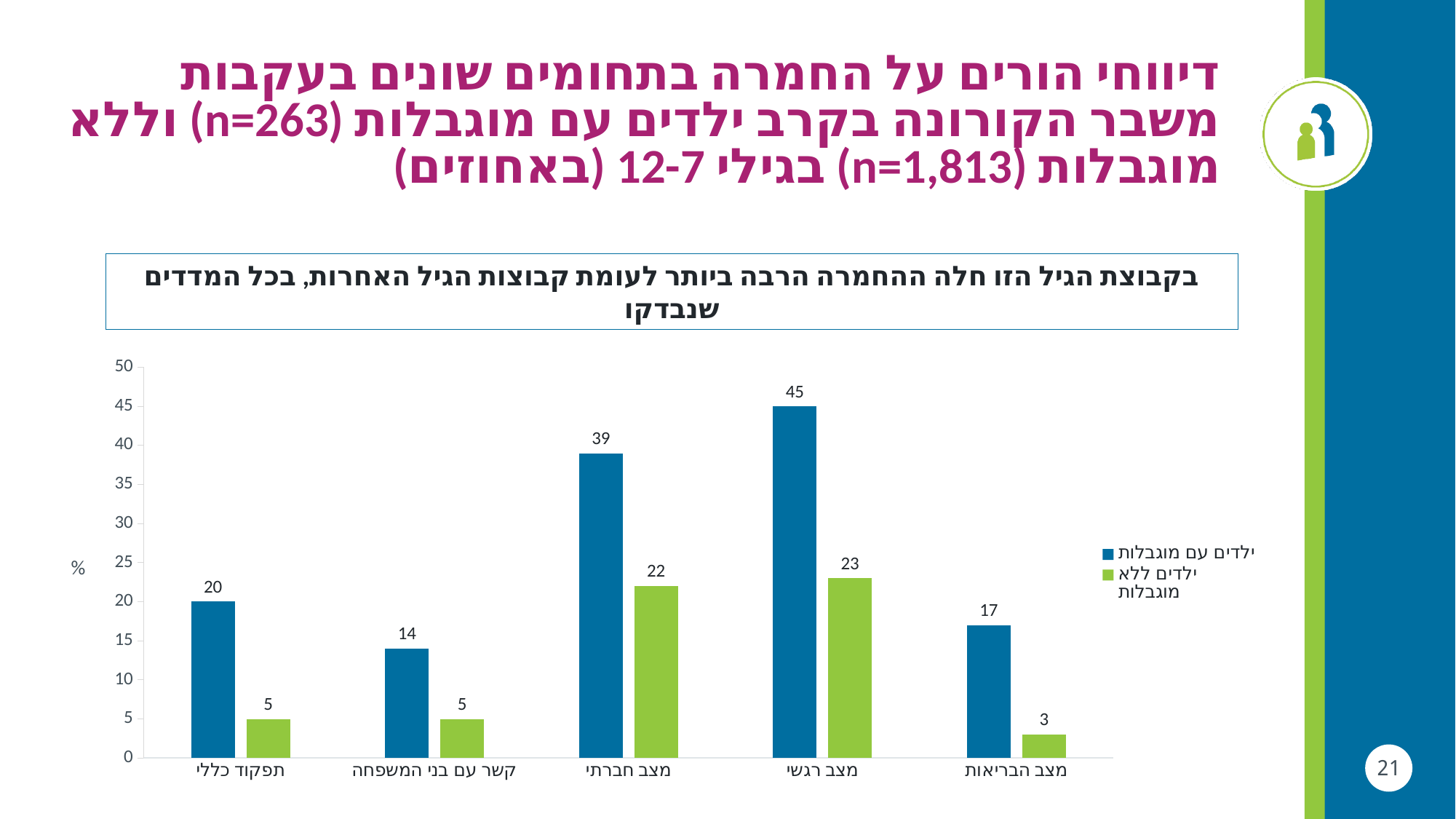
What is the value for ילדים עם מוגבלות in the מצב רגשי category? 45 What kind of chart is shown on the slide? bar chart What is the value for ילדים עם מוגבלות in the תפקוד כללי category? 20 How many series does the legend list? 2 What unit label is shown on the y axis? % Which category has the lowest value for ילדים ללא מוגבלות? מצב הבריאות What is the value for ילדים ללא מוגבלות in the מצב חברתי category? 22 How many categories are shown on the x axis? 5 What is the difference between ילדים עם מוגבלות and ילדים ללא מוגבלות in the מצב הבריאות category? 14 Which is larger in the קשר עם בני המשפחה category: ילדים עם מוגבלות or ילדים ללא מוגבלות? ילדים עם מוגבלות Which category has the highest value for ילדים עם מוגבלות? מצב רגשי Is the value for ילדים עם מוגבלות in מצב חברתי greater or less than 35? greater